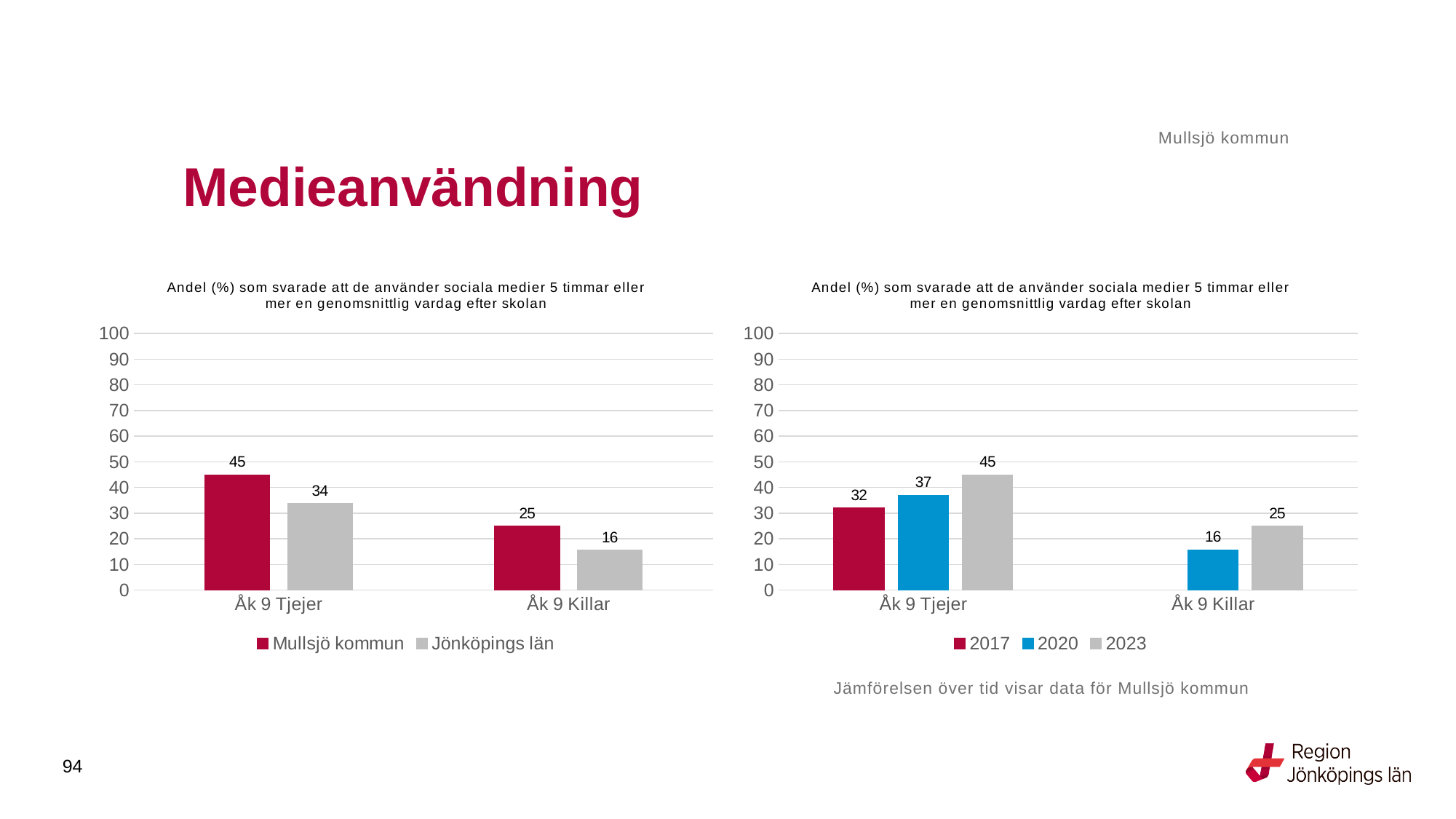
In the right chart, what is the value for 2020 for Åk 9 Tjejer? 37 In the right chart, how many series does the legend list? 3 In the right chart, what is the value for 2023 for Åk 9 Killar? 25 In the left chart, what is the value for Jönköpings län for Åk 9 Killar? 16 In the left chart, which is larger for Åk 9 Killar: Mullsjö kommun or Jönköpings län? Mullsjö kommun In the left chart, what is the value for Mullsjö kommun for Åk 9 Tjejer? 45 What kind of chart is the left chart? Bar chart In the right chart, do the values for Åk 9 Tjejer rise or fall from 2017 to 2023? Rise In the left chart, what is the difference between Mullsjö kommun and Jönköpings län for Åk 9 Tjejer? 11 In the left chart, how many series does the legend list? 2 In the right chart, what is the difference between the 2023 and 2017 values for Åk 9 Tjejer? 13 In the right chart, which year has the highest value for Åk 9 Tjejer? 2023